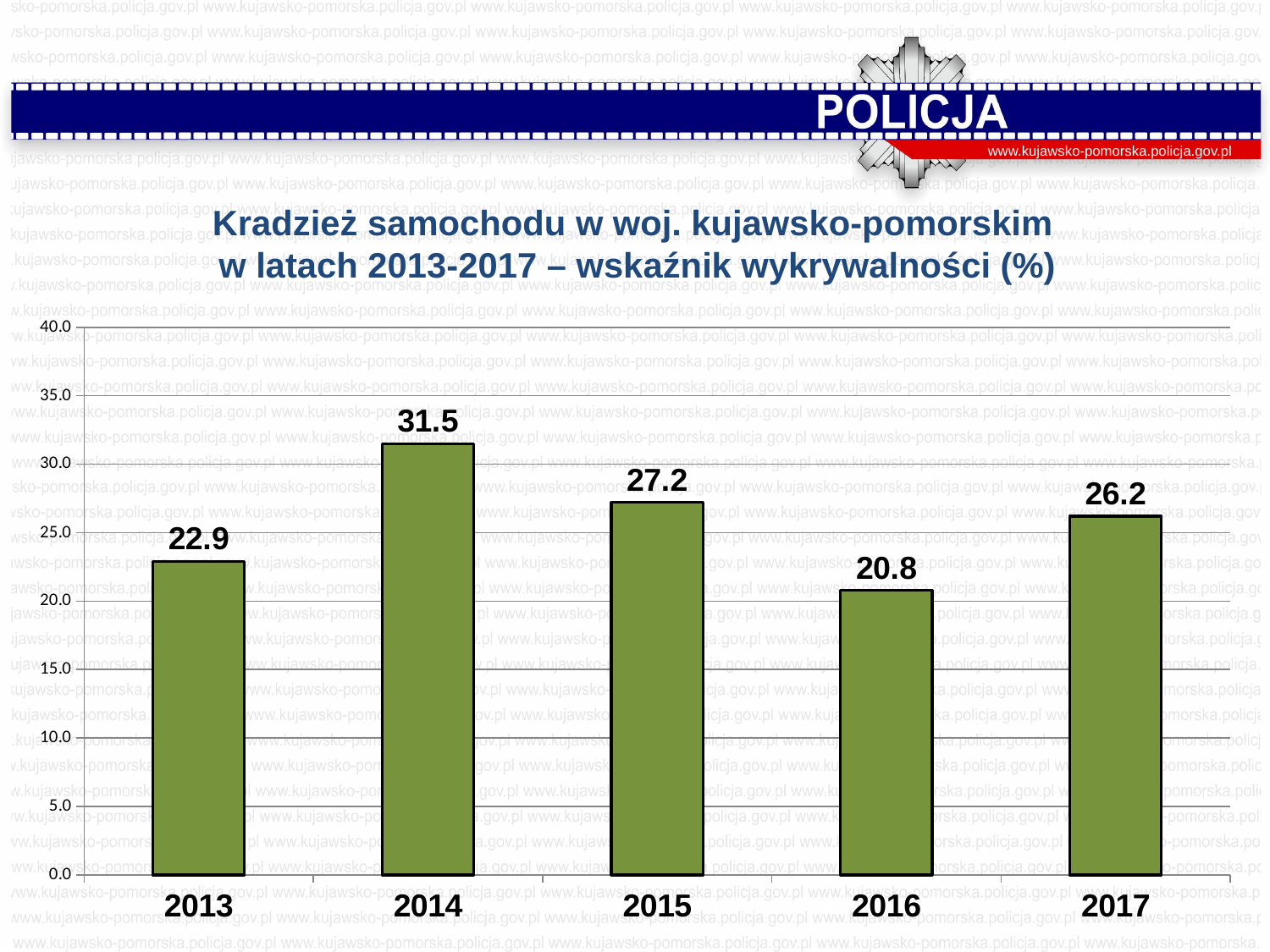
Which year has the lowest value? 2016 Does the value rise or fall from 2015 to 2016? fall What is the difference between the values for 2014 and 2013? 8.6 What is the detection rate value shown for 2014? 31.5 What is the difference between the values for 2015 and 2017? 1.0 What is the value shown for 2016? 20.8 What kind of chart is shown on the slide? bar chart How many years are shown on the x axis? 5 Is the value for 2014 greater or less than 30.0? greater Which is larger, the value for 2015 or the value for 2017? 2015 Which year has the highest value? 2014 What is the value shown for 2013? 22.9